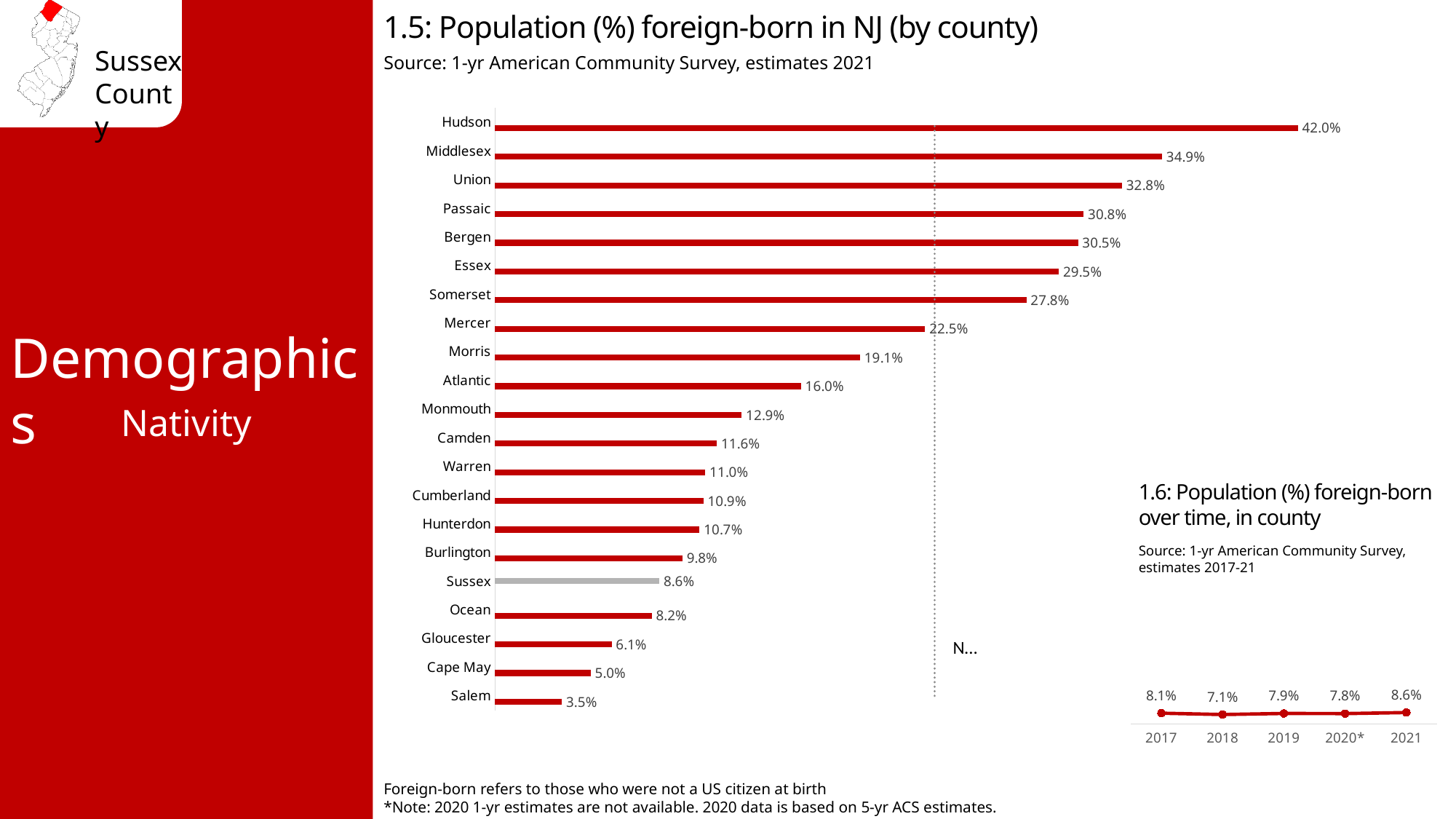
In chart 1.5 (Population (%) foreign-born in NJ by county), what is the difference between Hudson and Middlesex? 7.1% What kind of chart is chart 1.5 (Population (%) foreign-born in NJ by county)? Bar chart In chart 1.5 (Population (%) foreign-born in NJ by county), what is the value for Hudson? 42.0% In chart 1.6 (Population (%) foreign-born over time, in county), what is the difference between 2021 and 2017? 0.5% In chart 1.6 (Population (%) foreign-born over time, in county), what is the value for 2018? 7.1% In chart 1.5 (Population (%) foreign-born in NJ by county), how many counties are shown? 21 In chart 1.5 (Population (%) foreign-born in NJ by county), what is the value for Sussex? 8.6% In chart 1.6 (Population (%) foreign-born over time, in county), which year has the highest value? 2021 In chart 1.5 (Population (%) foreign-born in NJ by county), which is larger, Bergen or Essex? Bergen In chart 1.5 (Population (%) foreign-born in NJ by county), which bar is coloured grey instead of red? Sussex In chart 1.5 (Population (%) foreign-born in NJ by county), which county has the highest value? Hudson In chart 1.5 (Population (%) foreign-born in NJ by county), which county has the lowest value? Salem